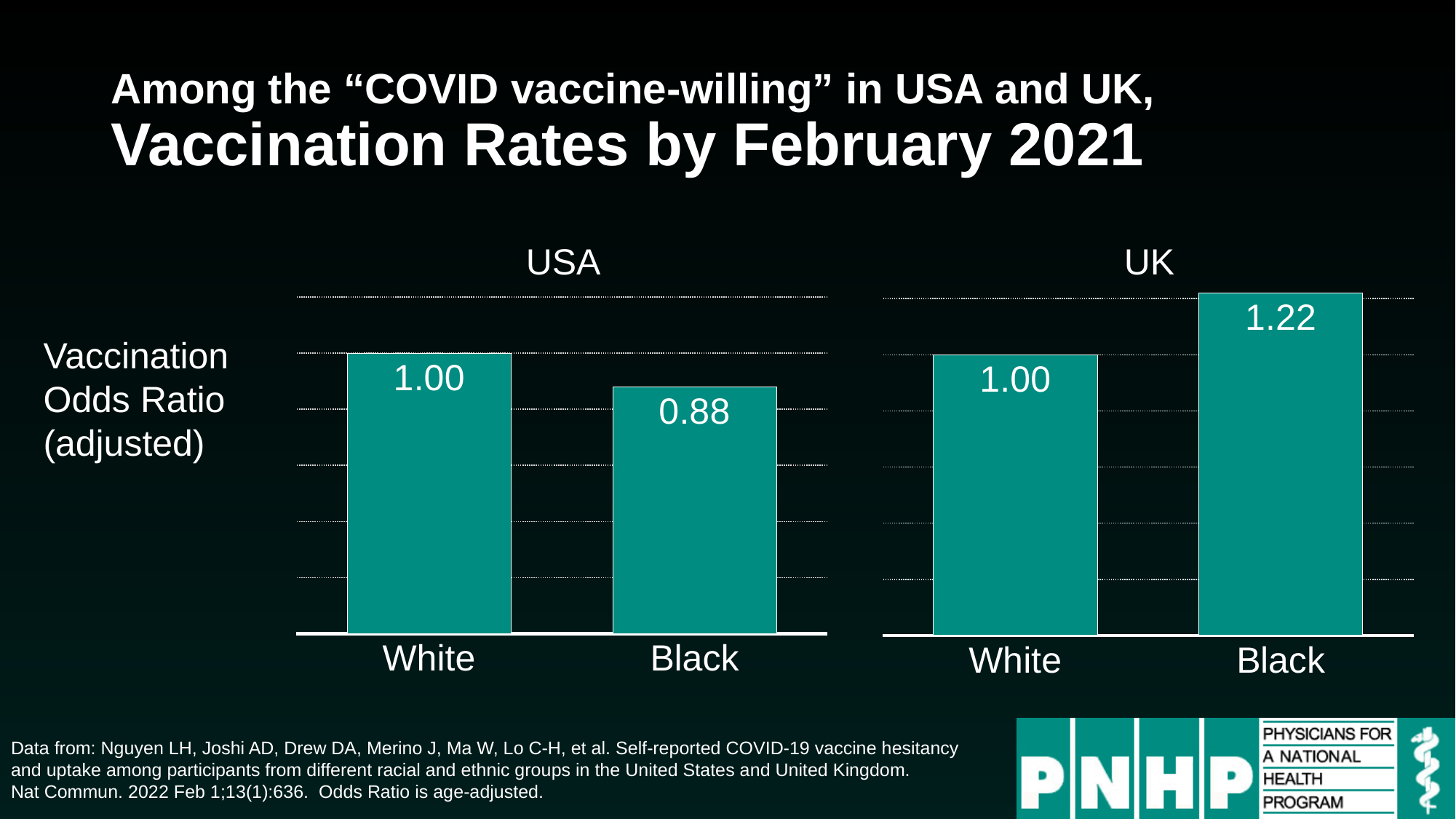
In the USA chart, what is the difference between the odds ratio for White and Black participants? 0.12 How many categories are shown in the USA chart? 2 What kind of chart is used for the UK data? Bar chart In the UK chart, what is the vaccination odds ratio for White participants? 1.00 In the USA chart, what is the vaccination odds ratio for Black participants? 0.88 In the USA chart, which group has the higher vaccination odds ratio? White What is the label of the vertical axis shown to the left of the charts? Vaccination Odds Ratio (adjusted) Is the odds ratio for Black participants larger in the USA chart or the UK chart? UK In the UK chart, which group has the lower vaccination odds ratio? White In the UK chart, what is the vaccination odds ratio for Black participants? 1.22 In the UK chart, what is the difference between the odds ratio for Black and White participants? 0.22 In the USA chart, what is the vaccination odds ratio for White participants? 1.00